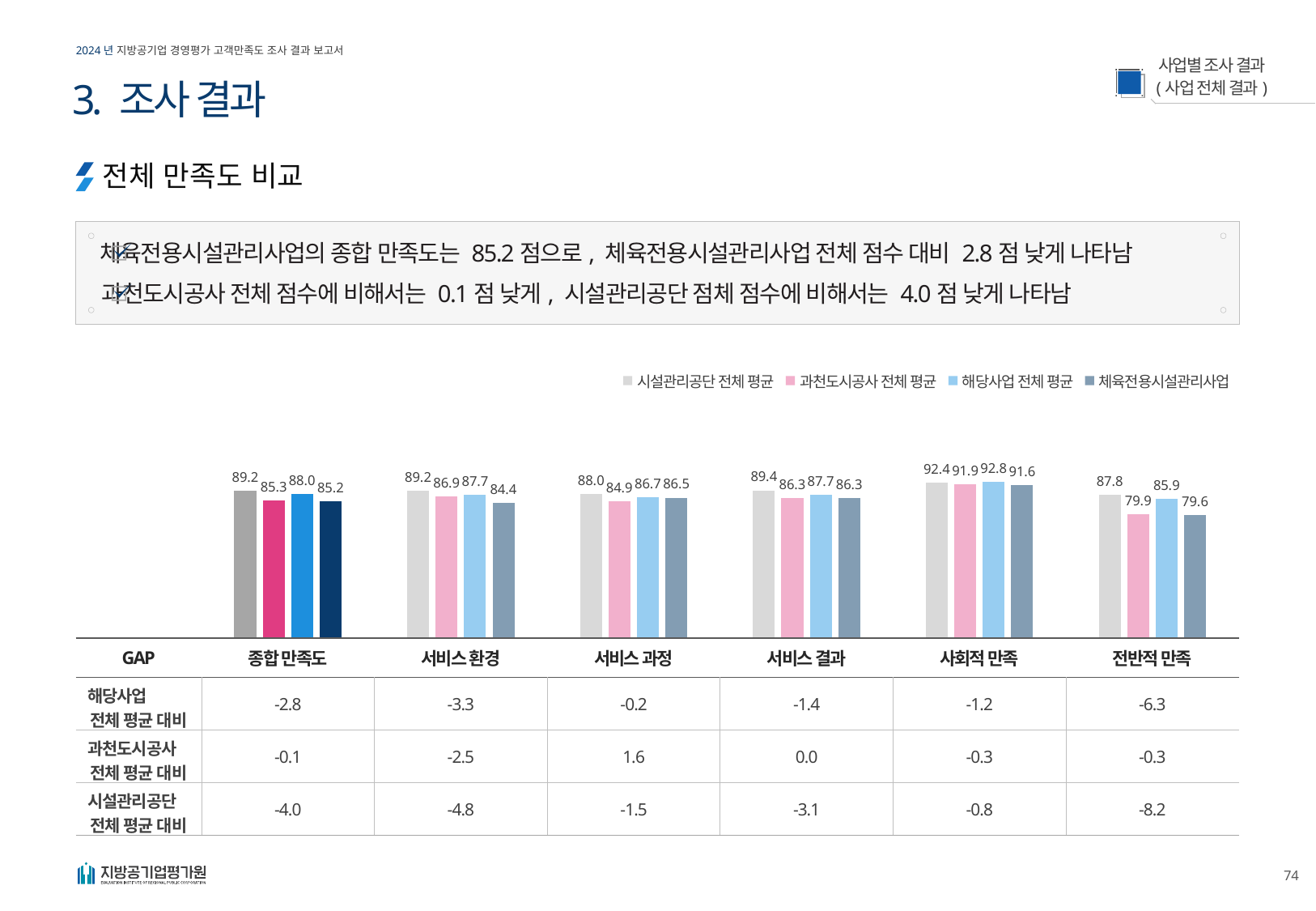
In which category does 체육전용시설관리사업 have its lowest value? 전반적 만족 What type of chart is shown on the slide? Bar chart What is the value for 시설관리공단 전체 평균 in the 사회적 만족 category? 92.4 Which series is shown in pink in the chart? 과천도시공사 전체 평균 In which category does 체육전용시설관리사업 have its highest value? 사회적 만족 How many categories are shown on the x axis of the chart? 6 What is the value for 해당사업 전체 평균 in the 서비스 과정 category? 86.7 What is the difference between 시설관리공단 전체 평균 and 체육전용시설관리사업 in the 전반적 만족 category? 8.2 How many series does the chart legend list? 4 What is the value for 체육전용시설관리사업 in the 종합 만족도 category? 85.2 In the 서비스 환경 category, which is larger: 과천도시공사 전체 평균 or 체육전용시설관리사업? 과천도시공사 전체 평균 What is the value for 과천도시공사 전체 평균 in the 전반적 만족 category? 79.9